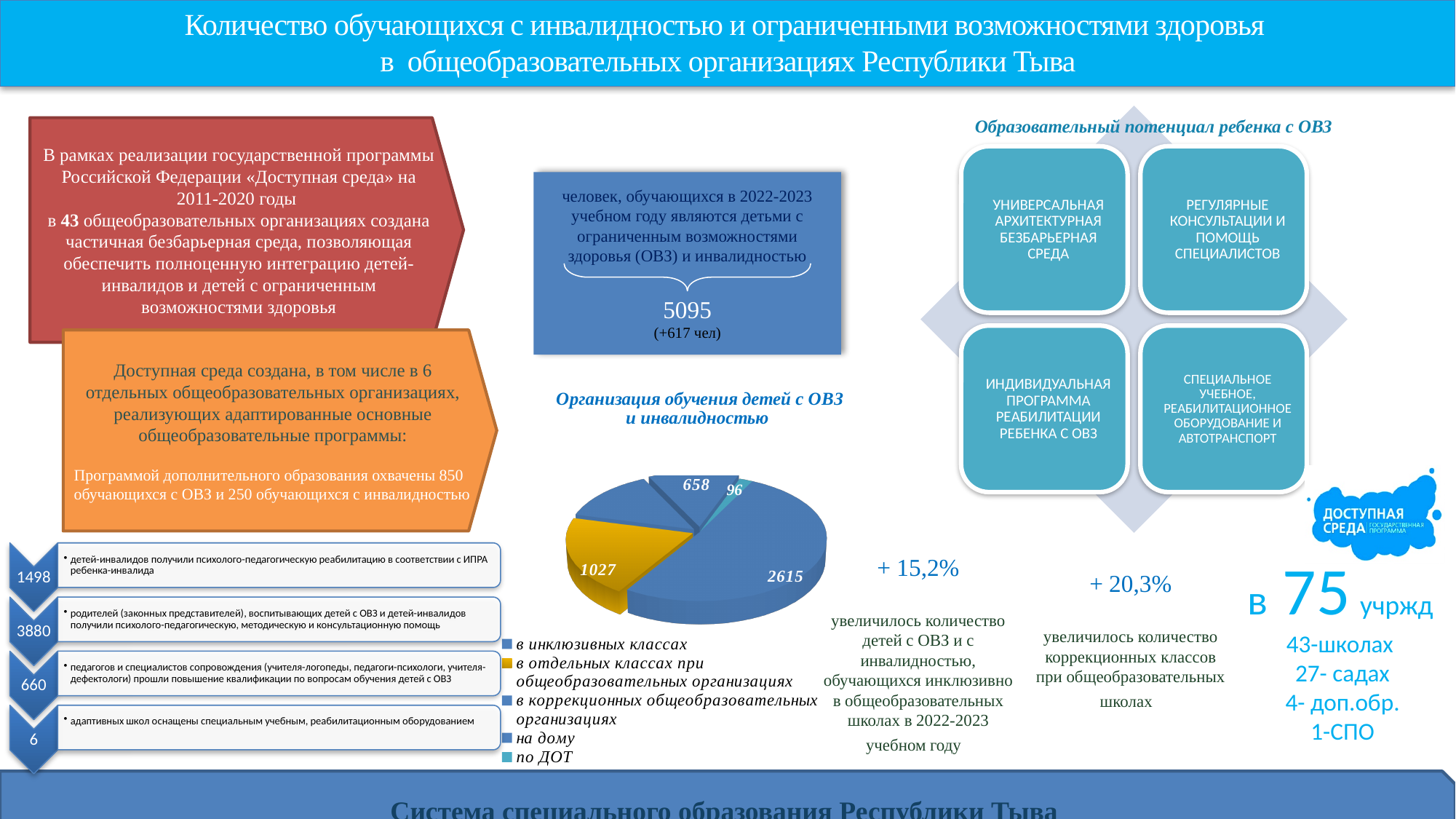
On the pie chart «Организация обучения детей с ОВЗ и инвалидностью», what is the difference between the slice labelled 658 and the slice labelled 96? 562 On the pie chart «Организация обучения детей с ОВЗ и инвалидностью», what is the difference between the slice labelled 2615 and the slice labelled 1027? 1588 What is the smallest value labelled on the pie chart «Организация обучения детей с ОВЗ и инвалидностью»? 96 On the pie chart «Организация обучения детей с ОВЗ и инвалидностью», what value is shown on the yellow slice («в отдельных классах при общеобразовательных организациях»)? 1027 What is the largest value labelled on the pie chart «Организация обучения детей с ОВЗ и инвалидностью»? 2615 How many categories does the legend of the pie chart «Организация обучения детей с ОВЗ и инвалидностью» list? 5 What is the title of the pie chart on the slide? Организация обучения детей с ОВЗ и инвалидностью What kind of chart is shown under the title «Организация обучения детей с ОВЗ и инвалидностью»? pie chart On the pie chart «Организация обучения детей с ОВЗ и инвалидностью», which is larger: the slice labelled 1027 or the slice labelled 658? 1027 Which legend entry of the pie chart «Организация обучения детей с ОВЗ и инвалидностью» is shown in yellow? в отдельных классах при общеобразовательных организациях On the pie chart «Организация обучения детей с ОВЗ и инвалидностью», what value is shown on the largest slice? 2615